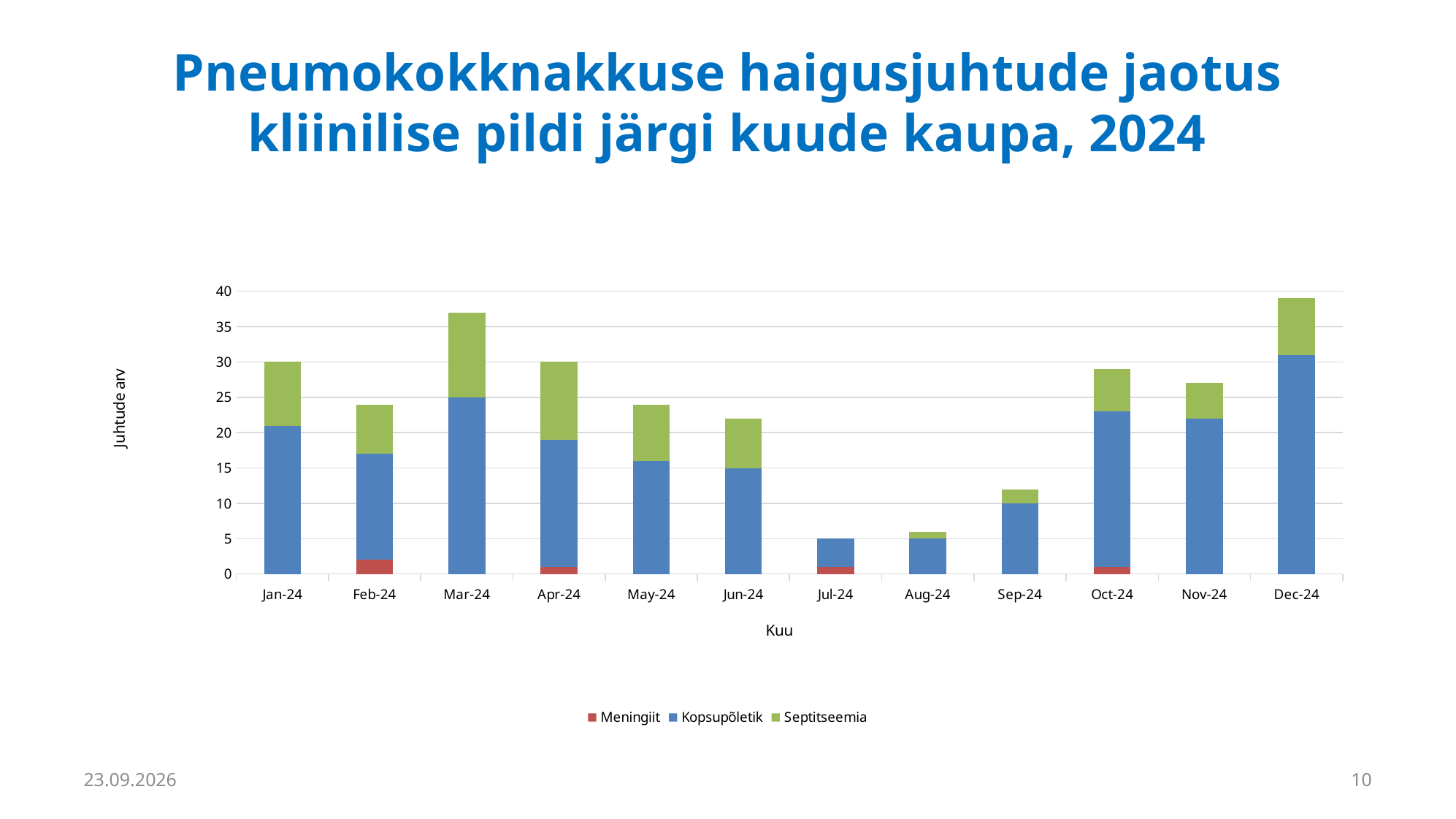
Which month has the tallest stacked bar? Dec-24 What kind of chart is shown on the slide? Stacked bar chart How many months (categories) are shown on the x axis? 12 Which series is shown in green in the legend? Septitseemia Is the total for Mar-24 greater or less than 35? greater What is the label of the y axis? Juhtude arv What is the total height of the stacked bar for Jul-24? 5 What is the total height of the stacked bar for Jan-24? 30 How many series does the legend list? 3 Which is larger, the total for Mar-24 or the total for Jan-24? Mar-24 Is the total for Jun-24 greater or less than 20? greater Is the total for Nov-24 greater or less than 30? less